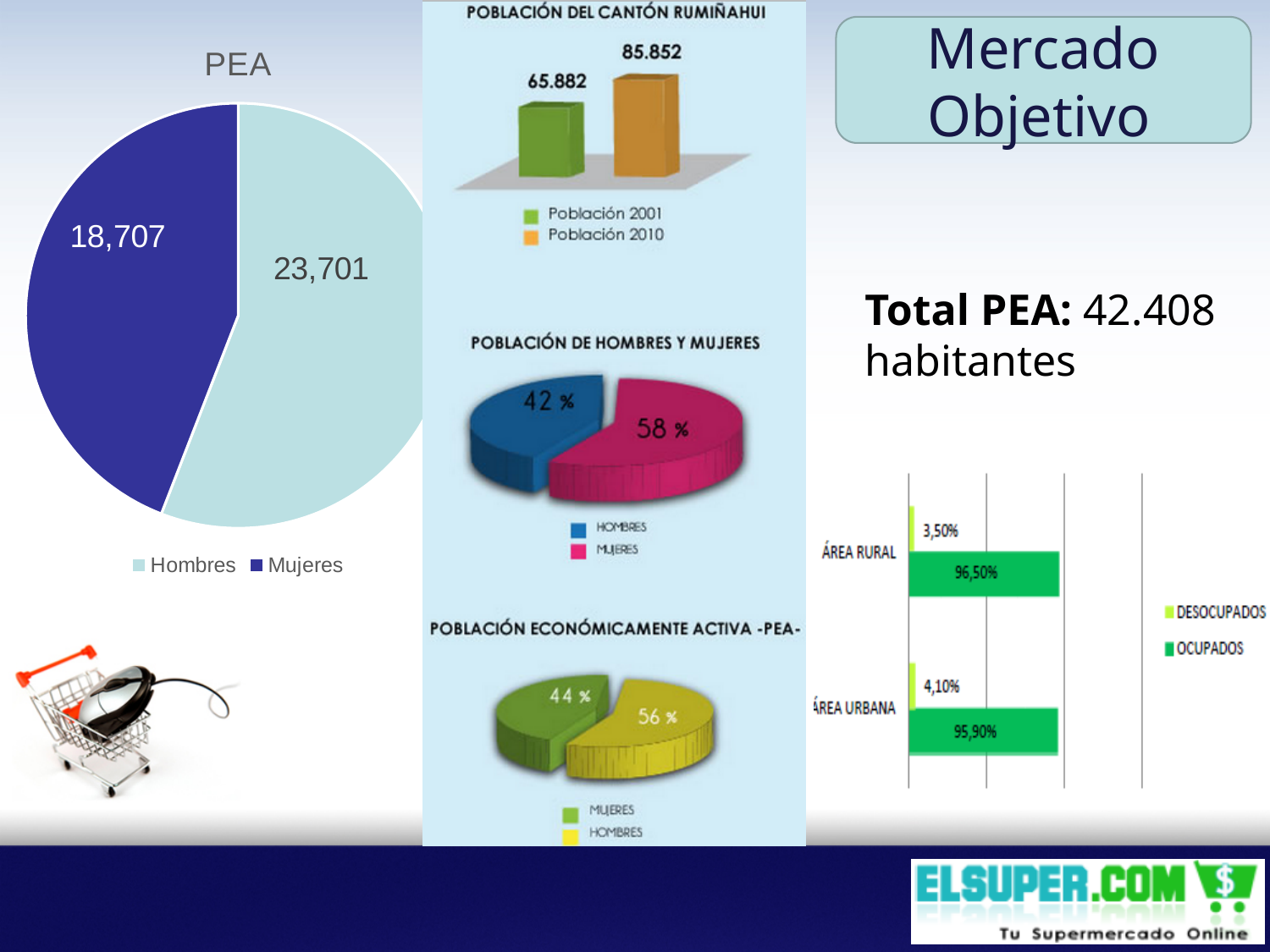
In the PEA pie chart on the left, which category is larger, Hombres or Mujeres? Hombres In the PEA pie chart on the left, what is the value for Hombres? 23,701 In the bar chart at the bottom right, what is the value for Ocupados in Área Rural? 96,50% What kind of chart is 'Población del Cantón Rumiñahui'? Bar chart In the PEA pie chart on the left, what is the difference between the Hombres and Mujeres values? 4,994 In the 'Población del Cantón Rumiñahui' chart, what is the value for Población 2010? 85.852 In the bar chart at the bottom right, what is the value for Desocupados in Área Urbana? 4,10% In the 'Población de hombres y mujeres' pie chart, what share is Mujeres? 58 % In the 'Población económicamente activa -PEA-' pie chart, what share is Hombres? 56 % In the 'Población del Cantón Rumiñahui' chart, what is the value for Población 2001? 65.882 In the PEA pie chart on the left, how many entries does the legend list? 2 In the PEA pie chart on the left, what is the value for Mujeres? 18,707